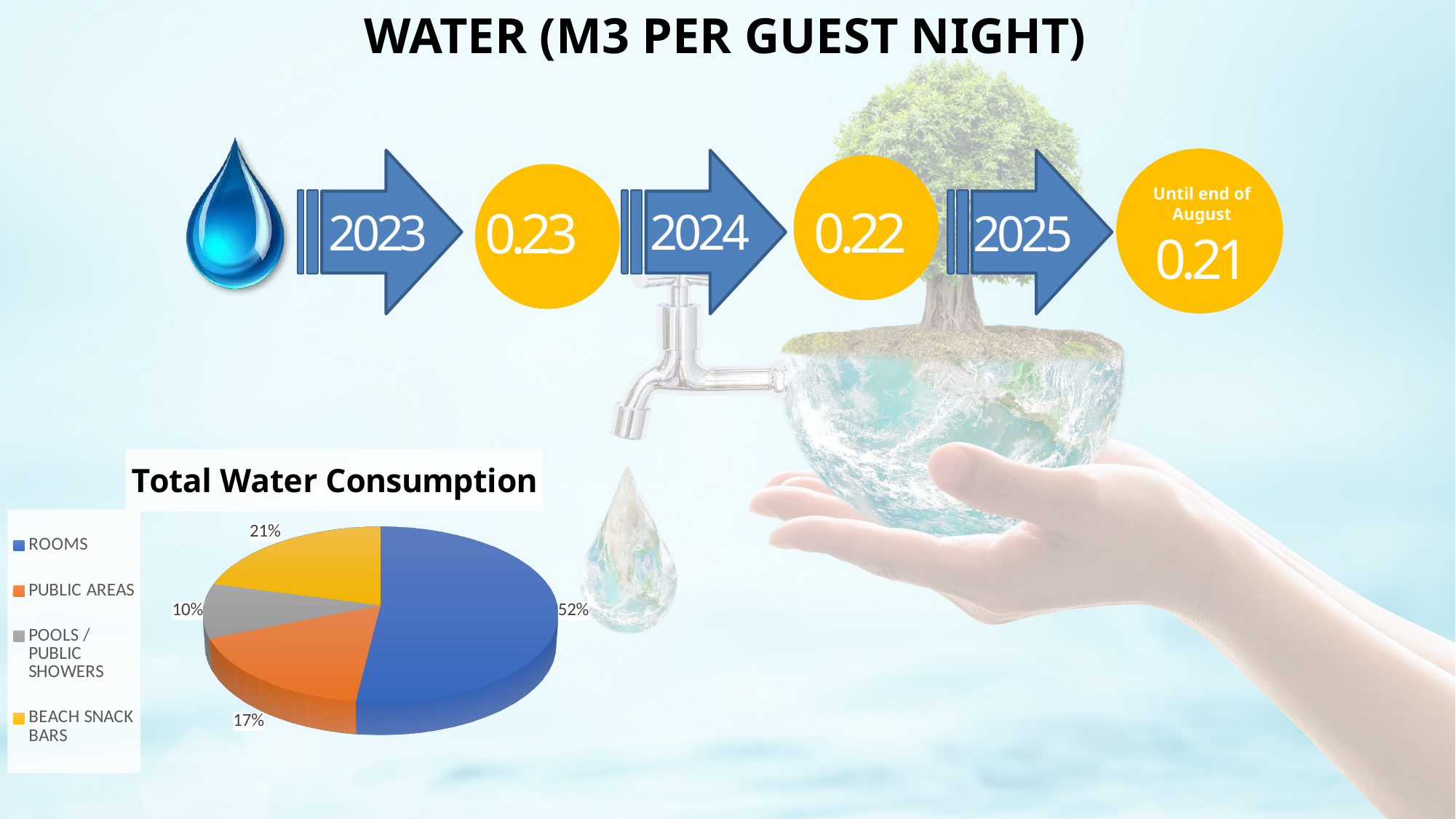
Which category has the smallest slice in the "Total Water Consumption" pie chart? POOLS / PUBLIC SHOWERS In the "Total Water Consumption" pie chart, what is the difference between the ROOMS share and the BEACH SNACK BARS share? 31% How many categories are shown in the "Total Water Consumption" pie chart? 4 Which category has the largest slice in the "Total Water Consumption" pie chart? ROOMS In the "Total Water Consumption" pie chart, what share does BEACH SNACK BARS have? 21% What kind of chart is "Total Water Consumption"? pie chart In the "Total Water Consumption" pie chart, what colour is the ROOMS slice? blue In the "Total Water Consumption" pie chart, what share does POOLS / PUBLIC SHOWERS have? 10% In the "Total Water Consumption" pie chart, what share does PUBLIC AREAS have? 17% In the "Total Water Consumption" pie chart, which is larger: PUBLIC AREAS or BEACH SNACK BARS? BEACH SNACK BARS What is the title of the pie chart on the slide? Total Water Consumption In the "Total Water Consumption" pie chart, what share does ROOMS have? 52%